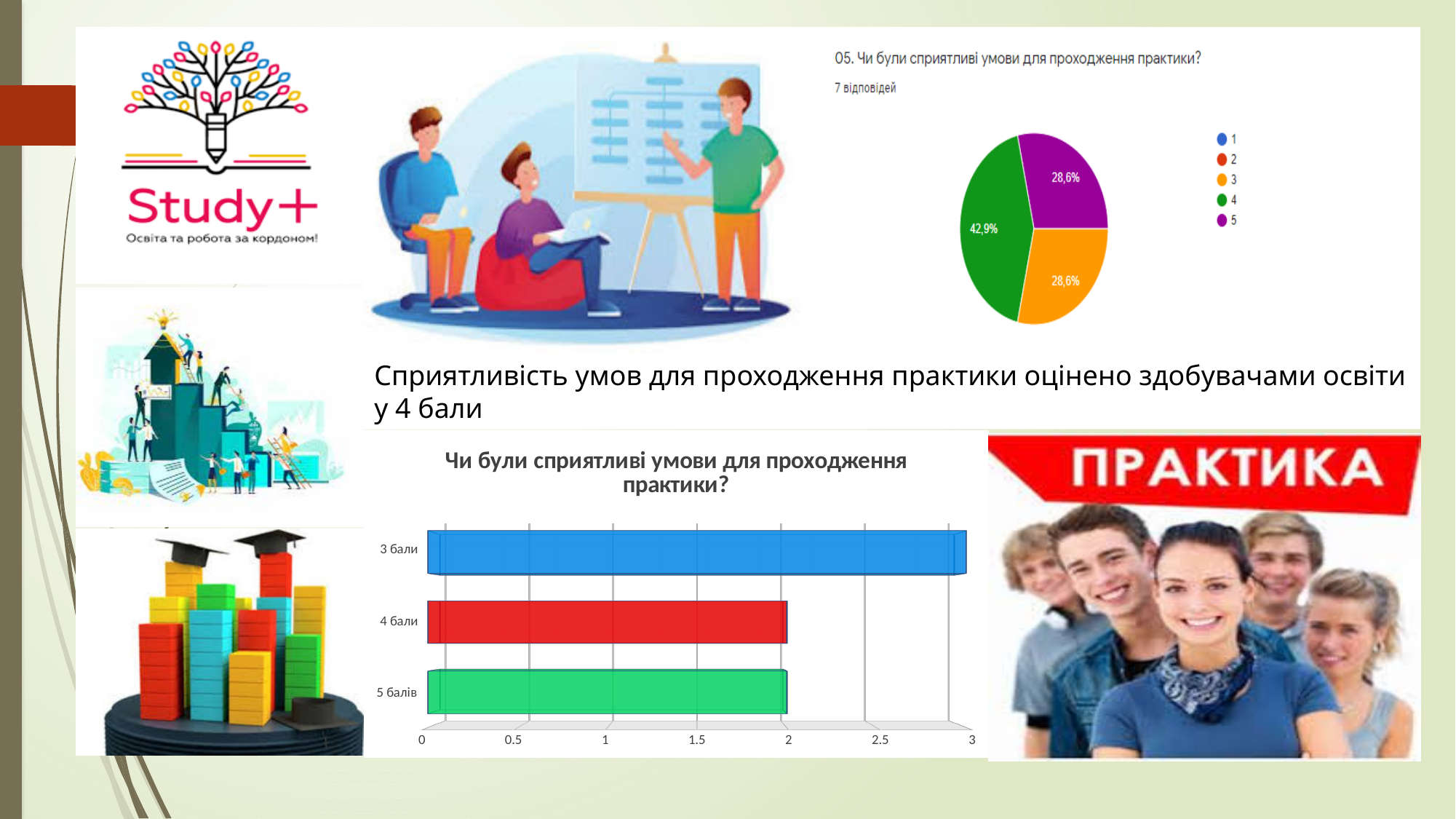
What type of chart is the chart at the bottom centre titled "Чи були сприятливі умови для проходження практики?"? bar chart In the bar chart at the bottom centre, how many categories are plotted? 3 In the bar chart at the bottom centre, what is the difference between the values for "3 бали" and "5 балів"? 1 In the bar chart at the bottom centre, what is the value for "3 бали"? 3 How many responses does the pie chart at the top right report ("відповідей")? 7 In the bar chart at the bottom centre, which category has the highest value? 3 бали In the pie chart at the top right, what share of responses is shown for the purple slice (rating 5)? 28,6% In the pie chart at the top right, which rating has the largest slice? 4 In the bar chart at the bottom centre, is the value for "5 балів" greater or less than 2.5? less How many entries does the legend of the pie chart at the top right list? 5 In the bar chart at the bottom centre, what is the value for "4 бали"? 2 In the pie chart at the top right, what share of responses is shown for the green slice (rating 4)? 42,9%